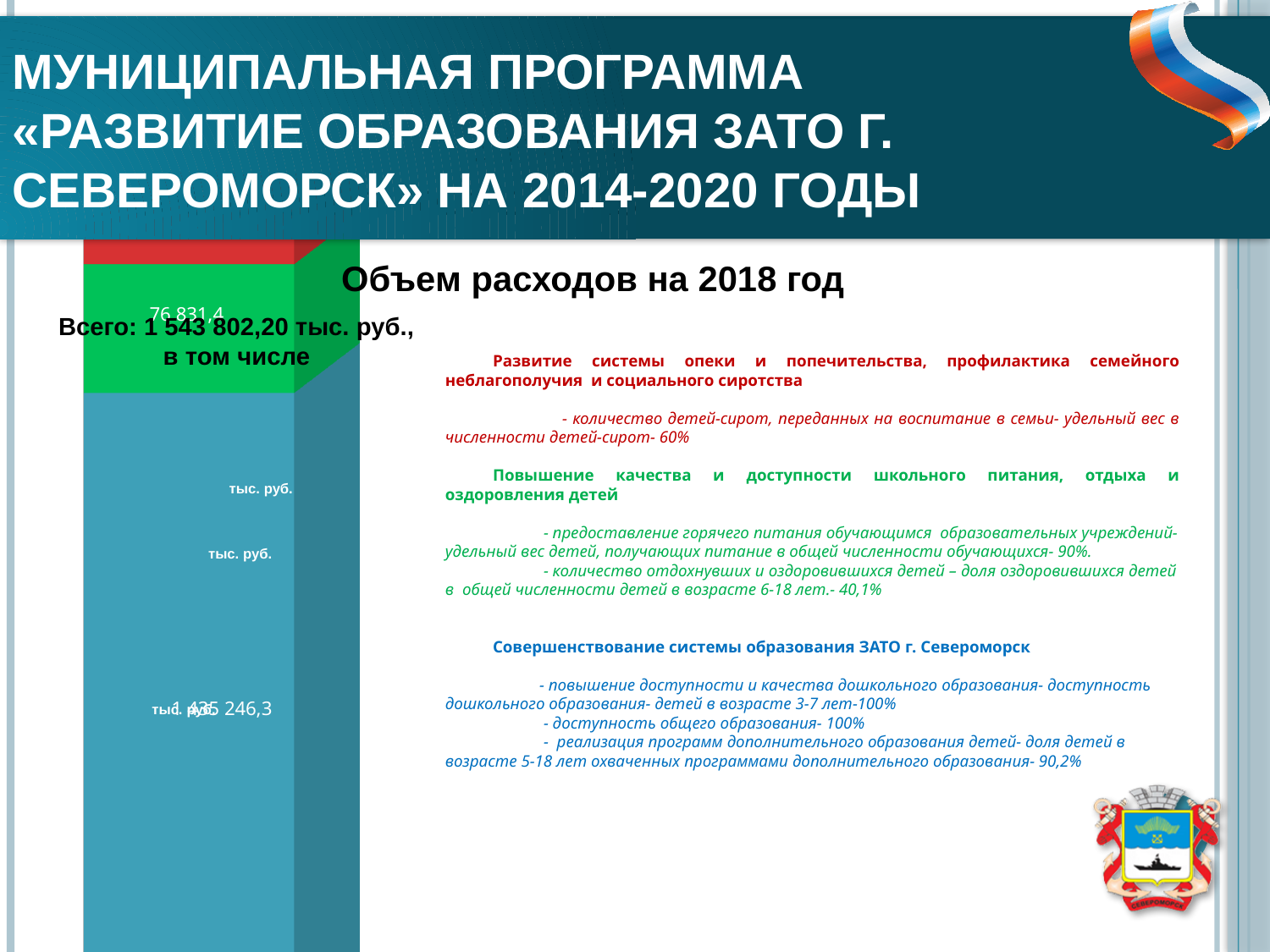
What heading is shown above the chart describing the expenditure year? Объем расходов на 2018 год Which is larger, the blue segment or the green segment of the stacked bar? the blue segment How many segments make up the stacked bar on the left of the slide? 3 What total expenditure is stated on the slide for the stacked bar (Всего)? 1 543 802,20 тыс. руб. What colour is the topmost segment of the stacked bar? red What value is labelled on the green segment of the stacked bar? 76 831,4 What value is labelled on the large blue segment of the stacked bar? 1 435 246,3 Which segment of the stacked bar is the largest? the blue segment (1 435 246,3) What is the difference between the blue segment value (1 435 246,3) and the green segment value (76 831,4)? 1 358 414,9 What kind of chart is shown on the left of the slide? stacked bar chart